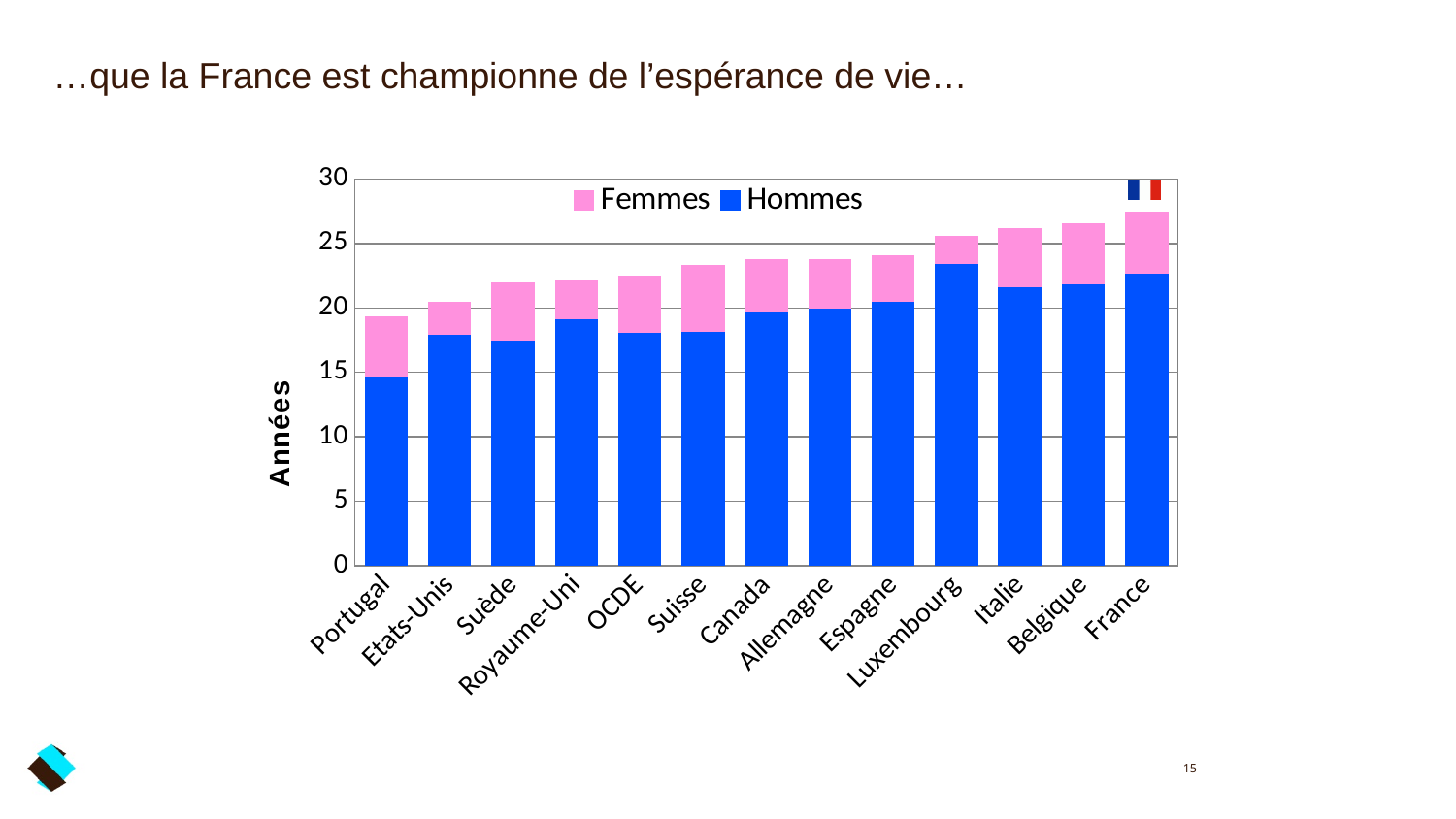
Is the total bar for Canada greater or less than 25? less Is the Hommes value for Luxembourg greater or less than 20? greater How many series does the chart's legend list? 2 How many countries or groups are shown along the x axis of the chart? 13 Which category has the highest total bar in the chart? France Do the total bar heights rise or fall from left to right along the x axis? rise Which category has the smallest Hommes value? Portugal Is the total bar for France greater or less than 25? greater What kind of chart is shown on the slide? Stacked bar chart What is the label on the vertical axis of the chart? Années Which category has the lowest total bar in the chart? Portugal